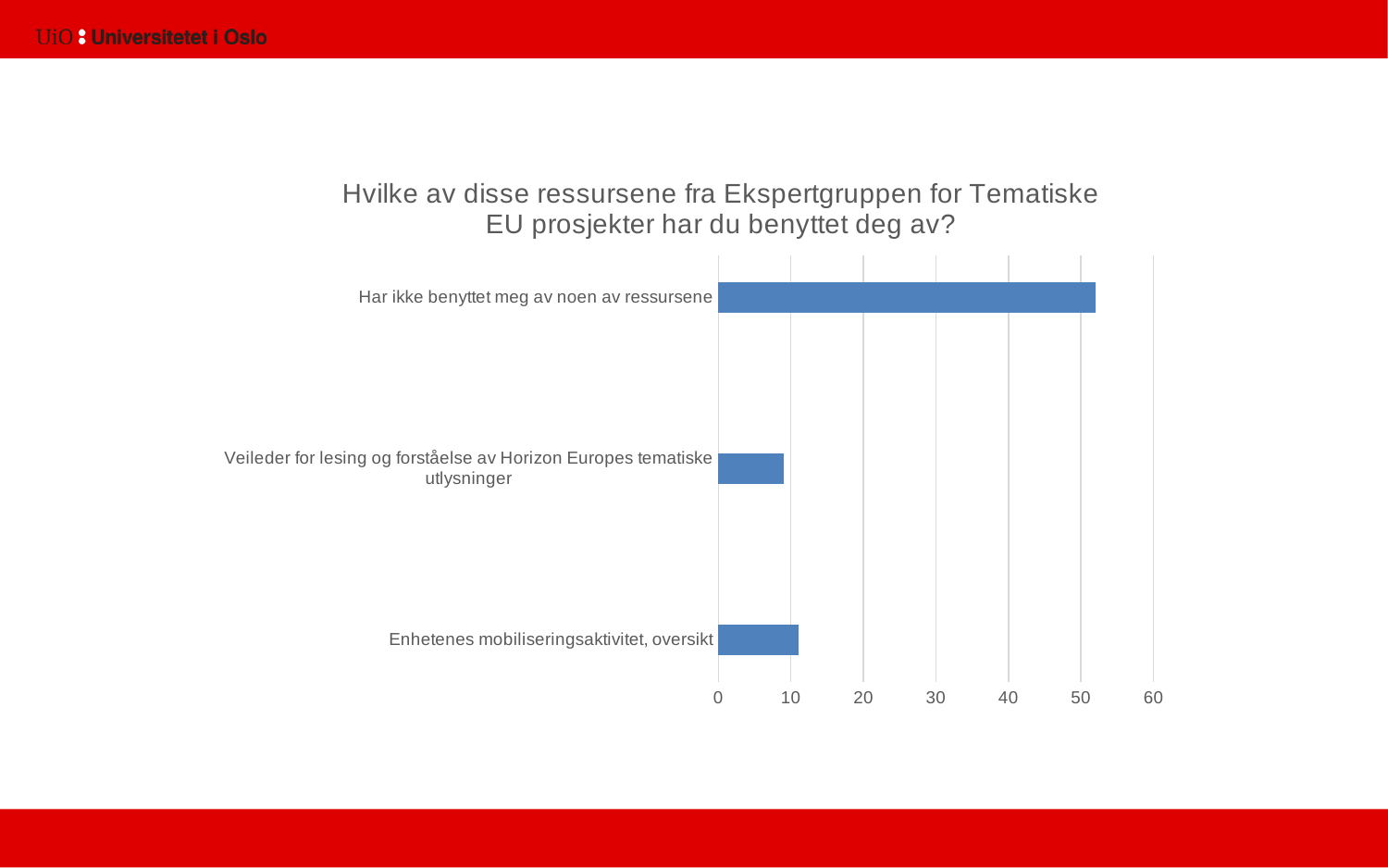
What kind of chart is shown on the slide? bar chart How many categories are shown in the chart? 3 Which category has the highest value? Har ikke benyttet meg av noen av ressursene Is the value for 'Har ikke benyttet meg av noen av ressursene' greater or less than 40? greater What is the title of the chart? Hvilke av disse ressursene fra Ekspertgruppen for Tematiske EU prosjekter har du benyttet deg av? Is the value for 'Enhetenes mobiliseringsaktivitet, oversikt' greater or less than 20? less Which is larger: the value for 'Har ikke benyttet meg av noen av ressursene' or the value for 'Veileder for lesing og forståelse av Horizon Europes tematiske utlysninger'? Har ikke benyttet meg av noen av ressursene Is the value for 'Veileder for lesing og forståelse av Horizon Europes tematiske utlysninger' greater or less than 20? less Which is larger: the value for 'Har ikke benyttet meg av noen av ressursene' or the value for 'Enhetenes mobiliseringsaktivitet, oversikt'? Har ikke benyttet meg av noen av ressursene What is the highest value shown on the horizontal axis? 60